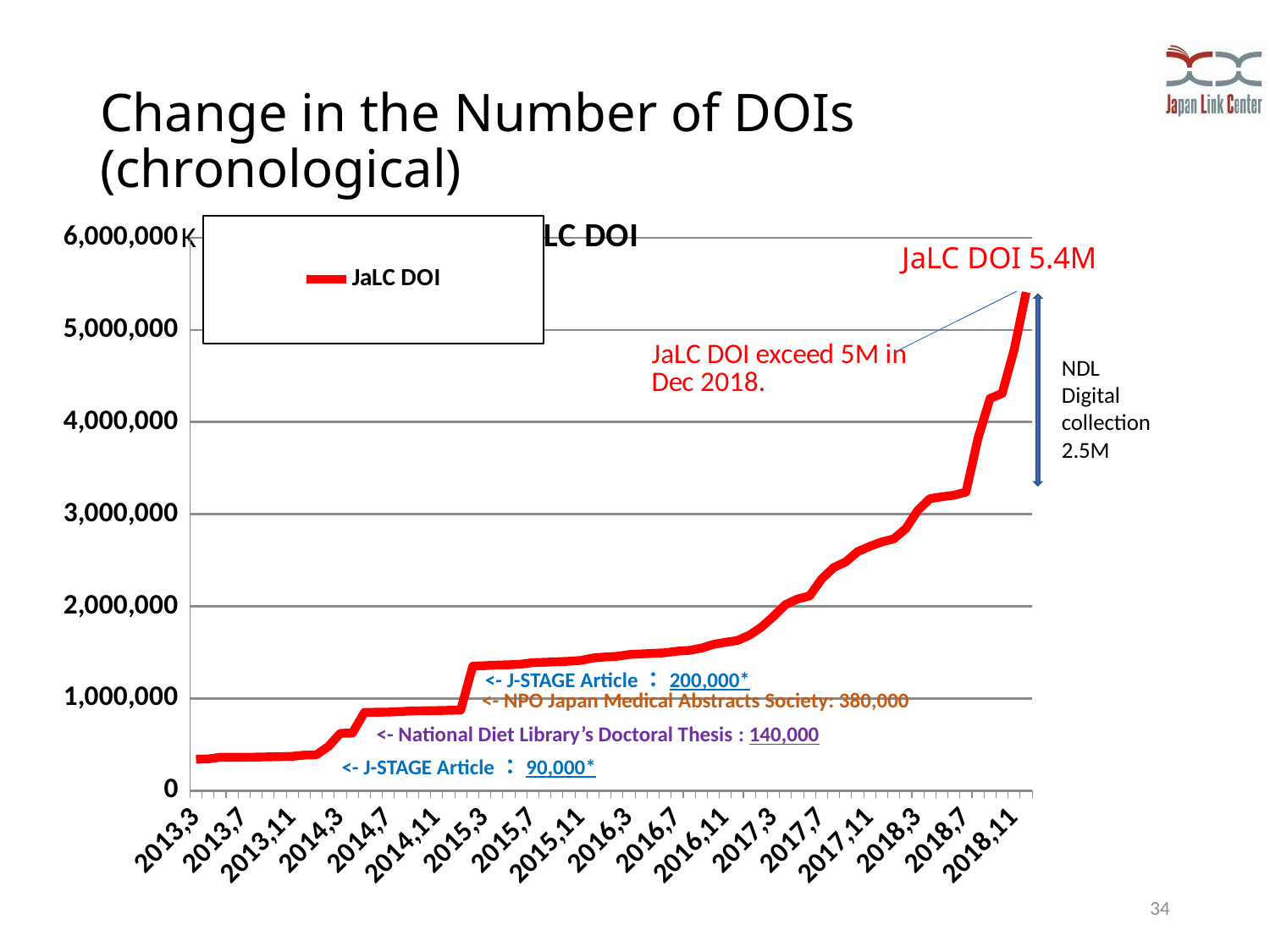
At which x-axis point is the JaLC DOI value lowest? 2013,3 Which is larger, the JaLC DOI value at 2015.3 or at 2014.7? 2015,3 Do the JaLC DOI values rise or fall along the x axis from 2013.3 to 2018.11? rise Is the JaLC DOI value at 2017.7 greater or less than 2,000,000? greater How many series does the chart legend list? 1 Is the JaLC DOI value at 2016.3 greater or less than 2,000,000? less What is the name of the series shown in the chart legend? JaLC DOI Is the JaLC DOI value at 2013.3 greater or less than 1,000,000? less What kind of chart is shown on the slide? line chart